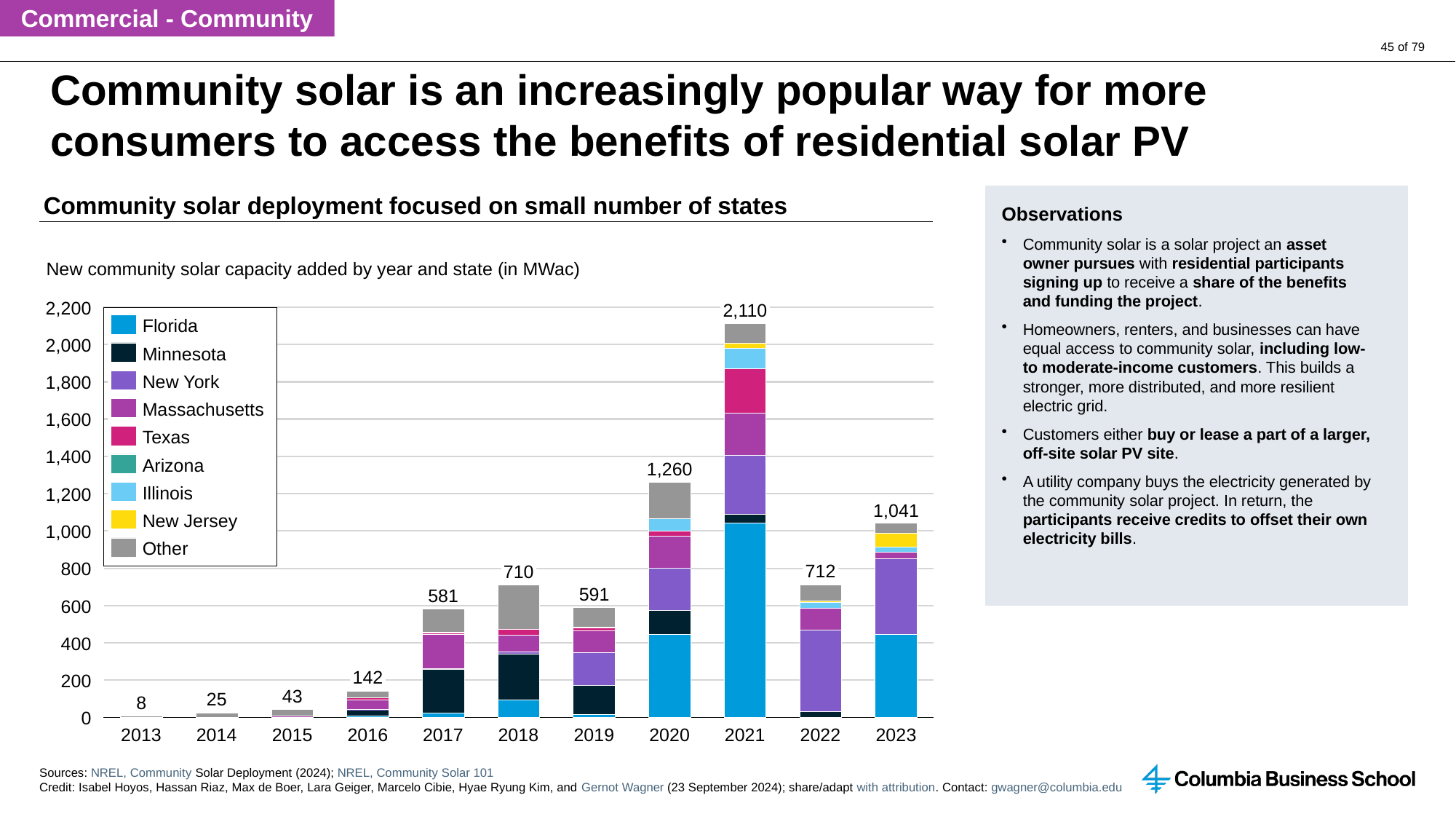
What was the new community solar capacity added in 2023? 1,041 Which year had the highest total new community solar capacity added? 2021 What was the new community solar capacity added in 2016? 142 What kind of chart is shown on the slide? Stacked bar chart What was the new community solar capacity added in 2021? 2,110 Is the Florida capacity added in 2021 greater or less than 800? greater Which year had a larger total capacity added, 2018 or 2019? 2018 What is the difference between the total capacity added in 2021 and in 2020? 850 How many years are shown on the x axis of the chart? 11 Which year had the lowest total new community solar capacity added? 2013 Did the total capacity added rise or fall from 2013 to 2021? Rise How many series does the chart legend list? 9